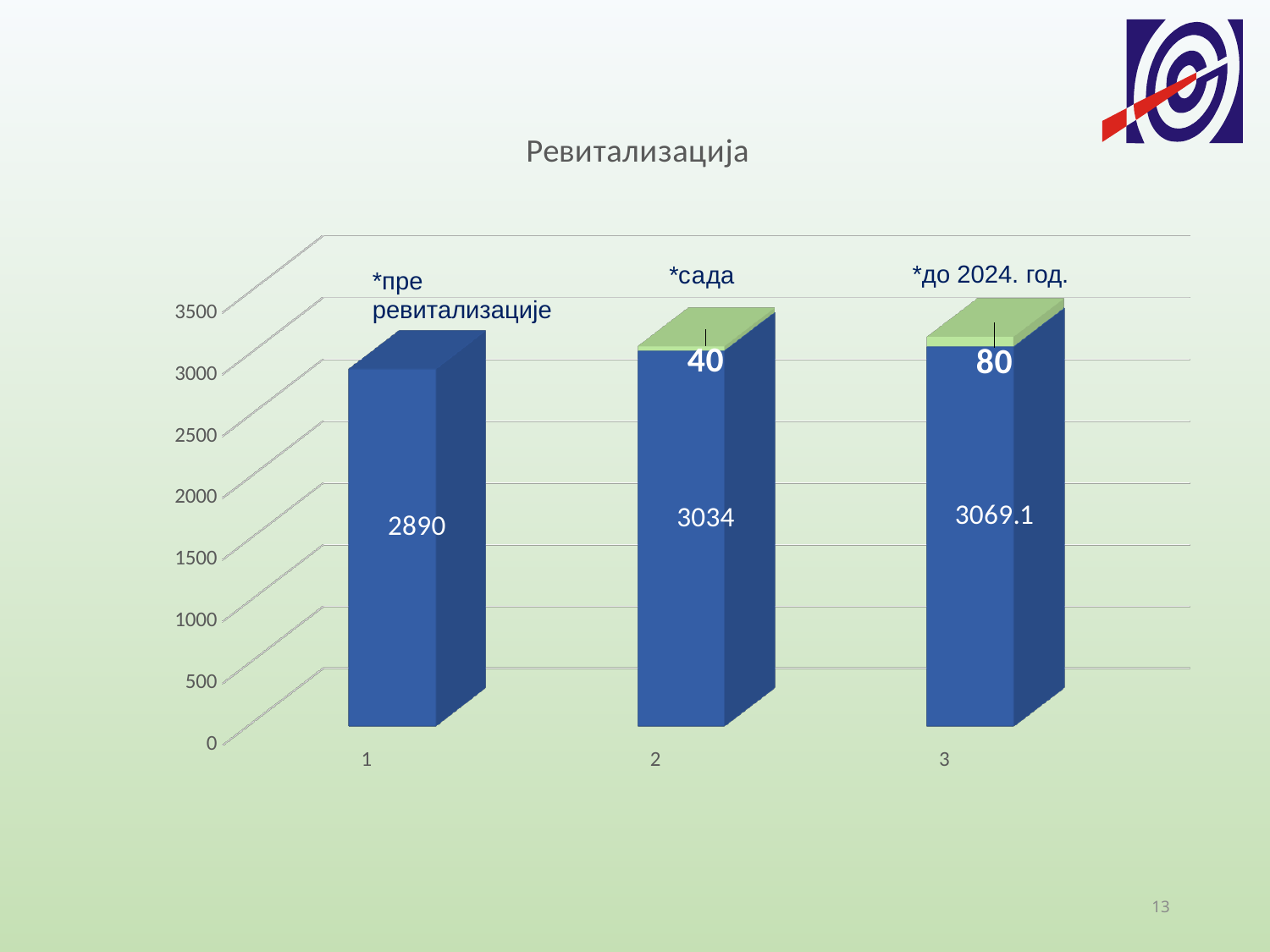
Which category has the highest blue segment value? 3 (*до 2024. год.) What is the total of the stacked bar for category 3 (*до 2024. год.)? 3149.1 What is the value of the green segment for category 3 (*до 2024. год.)? 80 Which category has the lowest blue segment value? 1 (*пре ревитализације) Is the green segment value larger for category 2 or category 3? Category 3 What is the value of the blue segment for category 3 (*до 2024. год.)? 3069.1 What is the value of the blue segment for category 2 (*сада)? 3034 What is the title of the chart? Ревитализација What is the difference between the blue values for category 2 and category 1? 144 What is the value of the green segment for category 2 (*сада)? 40 How many bars are shown in the chart? 3 What is the value of the blue segment for category 1 (*пре ревитализације)? 2890